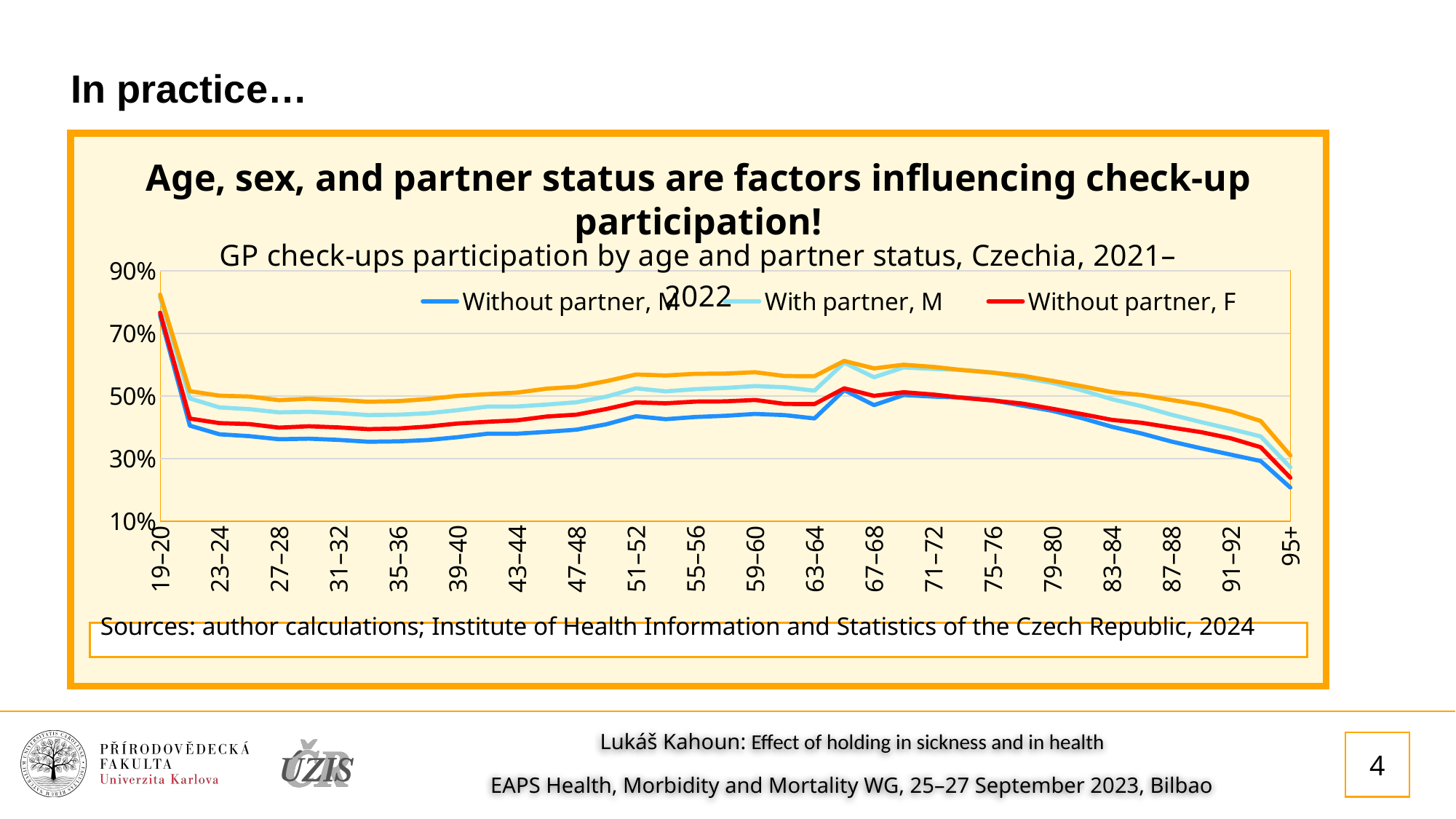
Is the value for 'Without partner, M' at age 95+ greater or less than 30%? less Is the value for 'Without partner, M' at age 19–20 greater or less than 70%? greater How many lines are plotted on the chart? 4 For which age group is the 'Without partner, M' line at its lowest? 95+ Is the value for 'Without partner, F' at age 95+ greater or less than 30%? less For which age group is the 'Without partner, M' line at its highest? 19–20 What kind of chart is shown on the slide? line chart How many age-group labels are shown on the x axis? 20 What is the title of the chart inside the box? GP check-ups participation by age and partner status, Czechia, 2021–2022 Do the lines rise or fall from age 71–72 to age 95+? fall At age 95+, which is larger: 'Without partner, F' or 'Without partner, M'? Without partner, F